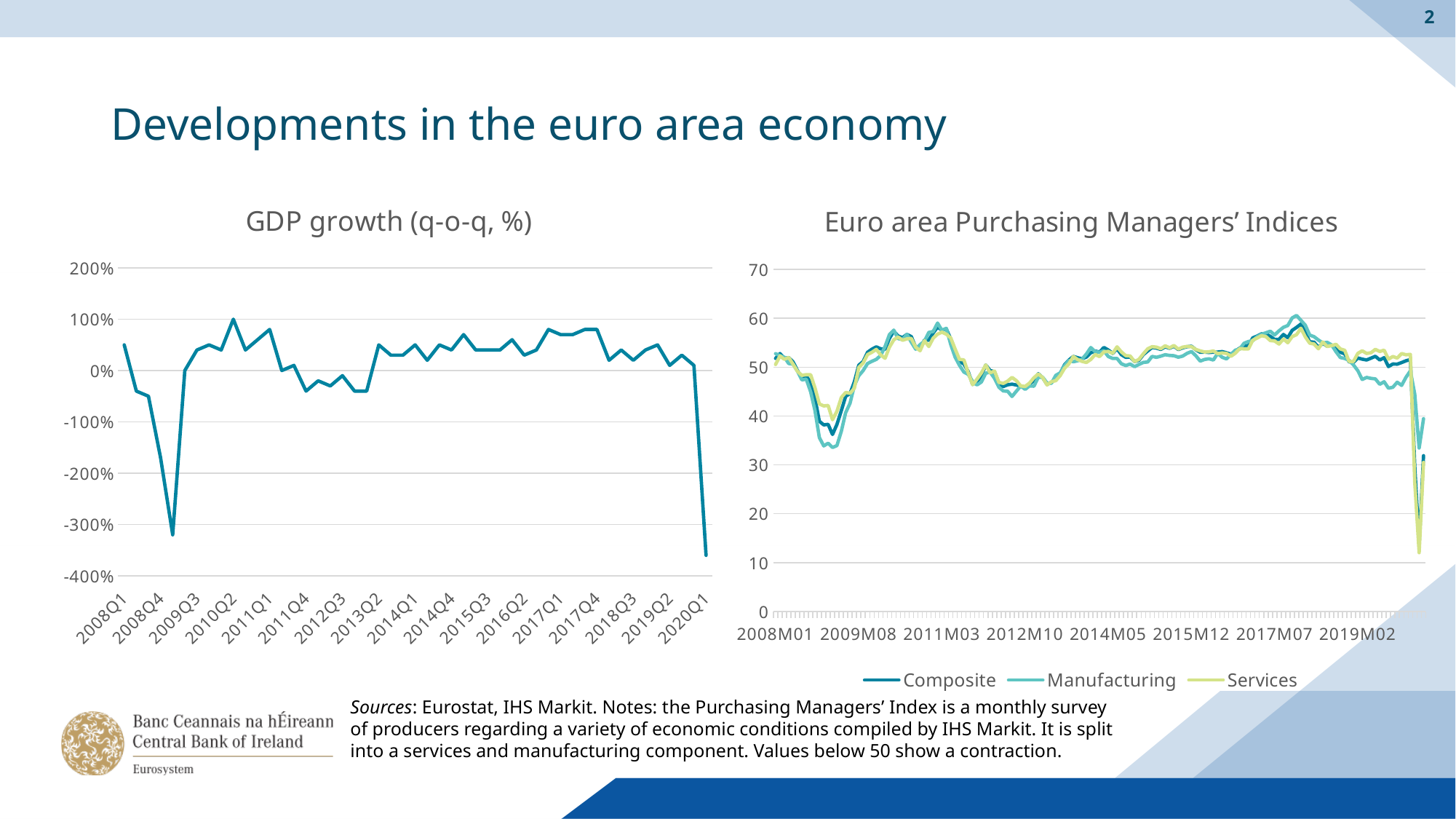
What is the highest value shown on the y axis of the 'GDP growth (q-o-q, %)' chart? 200% In the 'GDP growth (q-o-q, %)' chart, is the value for 2020Q1 greater or less than -300%? less In the 'Euro area Purchasing Managers' Indices' chart, which series are listed in the legend? Composite, Manufacturing, Services In the 'Euro area Purchasing Managers' Indices' chart, is the Manufacturing value at its 2009 low greater or less than 40? less In the 'Euro area Purchasing Managers' Indices' chart, do the values rise or fall between 2008M01 and early 2009? fall What kind of chart is the 'GDP growth (q-o-q, %)' chart? line chart In the 'Euro area Purchasing Managers' Indices' chart, is the lowest Services value at the end of the series greater or less than 20? less What kind of chart is the 'Euro area Purchasing Managers' Indices' chart? line chart How many series does the legend of the 'Euro area Purchasing Managers' Indices' chart list? 3 In the 'GDP growth (q-o-q, %)' chart, which quarter has the lowest value? 2020Q1